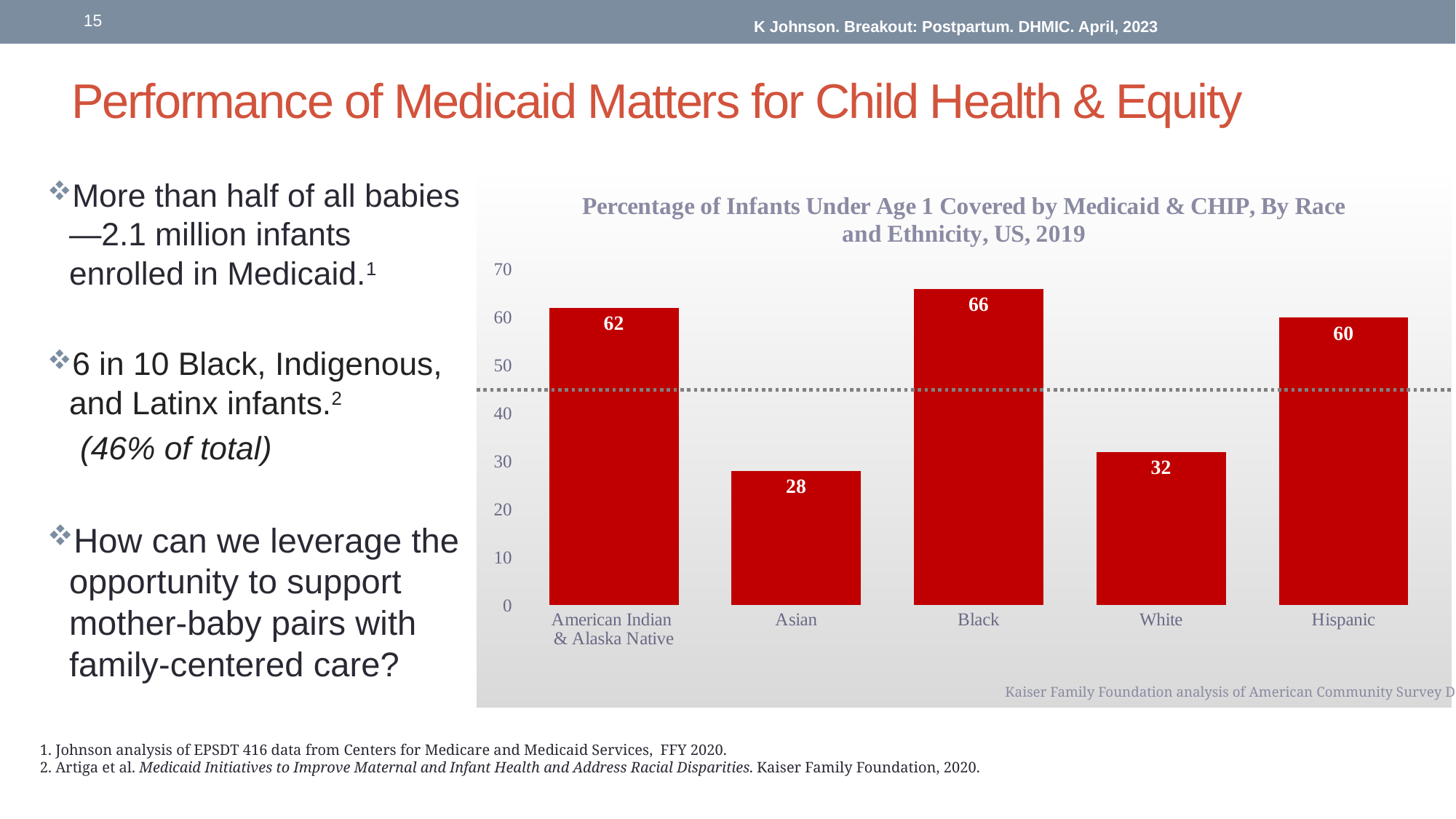
What is the value for Hispanic infants? 60 What is the difference between the values for Black and White infants? 34 Which is larger, the value for American Indian & Alaska Native or the value for White? American Indian & Alaska Native What is the title of the chart? Percentage of Infants Under Age 1 Covered by Medicaid & CHIP, By Race and Ethnicity, US, 2019 What is the value for White infants? 32 What is the difference between the values for American Indian & Alaska Native and Hispanic infants? 2 Which category has the lowest value? Asian How many categories are shown on the chart? 5 What is the value for Asian infants? 28 What kind of chart is shown on the slide? Bar chart What is the value for Black infants? 66 Which category has the highest value? Black